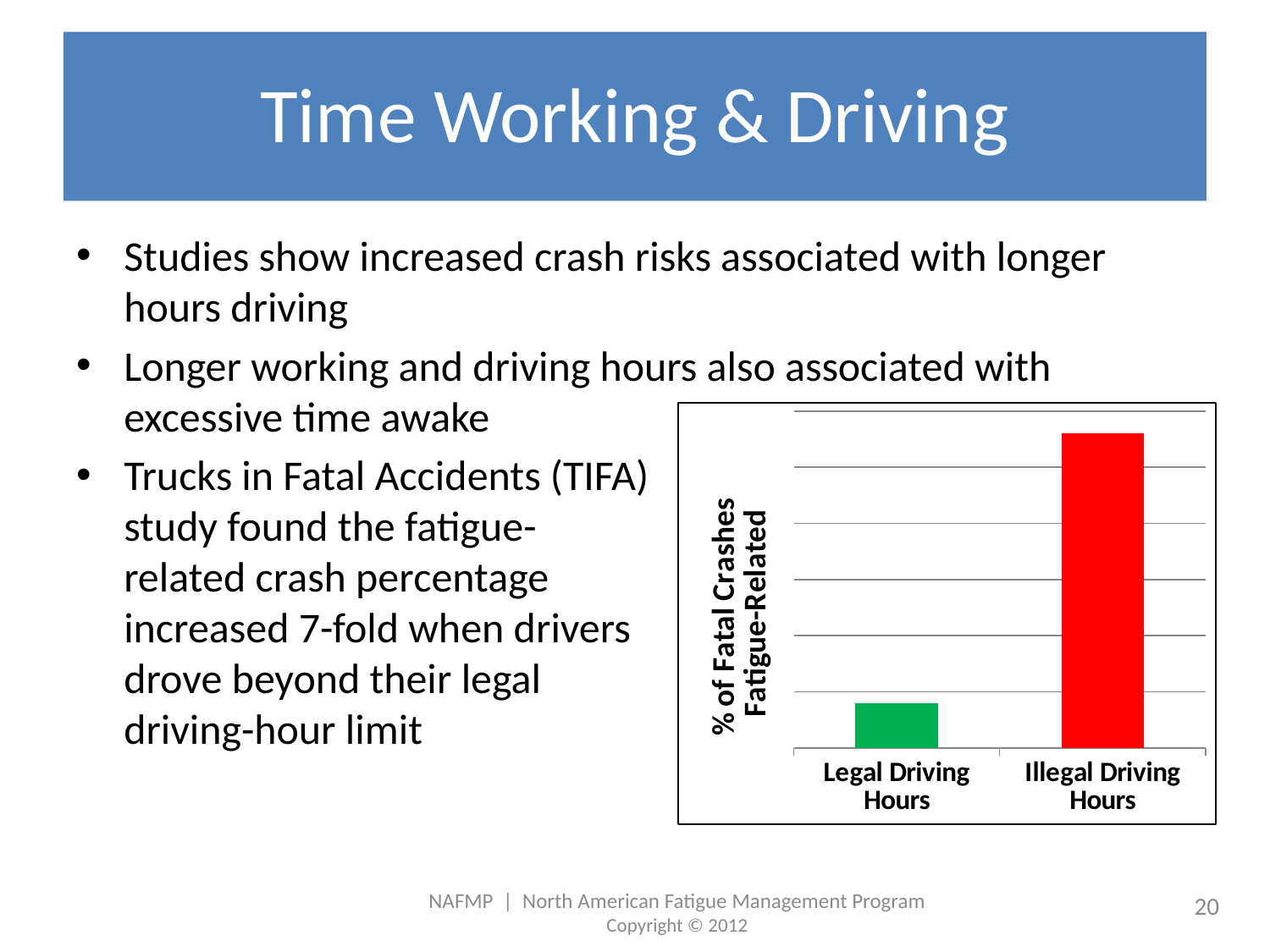
Which category has the highest value on the chart? Illegal Driving Hours How many categories are plotted on the chart? 2 Which category has the lowest value on the chart? Legal Driving Hours What is the label of the vertical axis on the chart? % of Fatal Crashes Fatigue-Related Which is larger on the chart: the value for Legal Driving Hours or the value for Illegal Driving Hours? Illegal Driving Hours What kind of chart is shown on the slide? bar chart What colour is the bar for Illegal Driving Hours? red